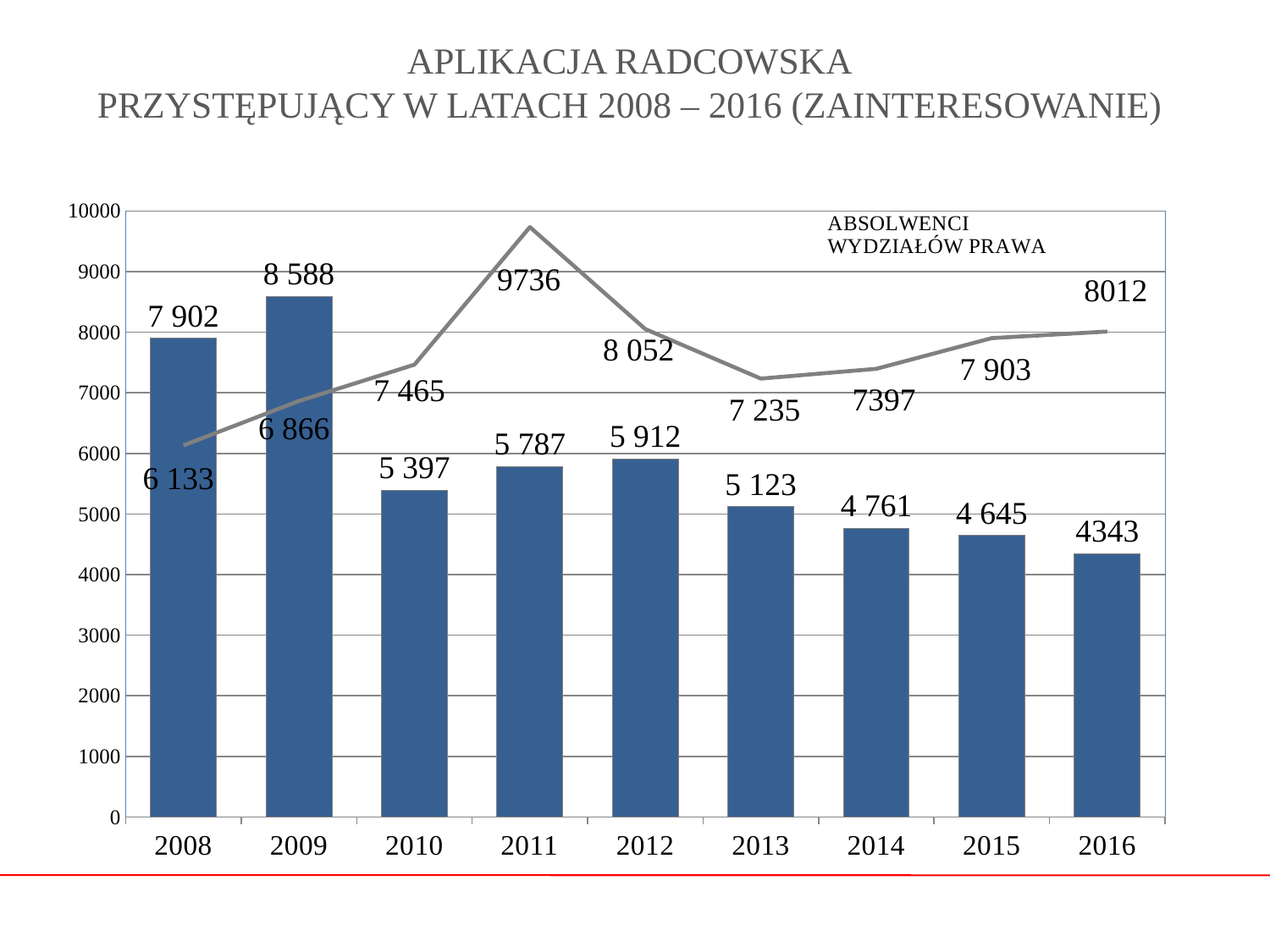
What kind of chart is shown on the slide? A combined bar and line chart What is the value of the bar for 2009? 8 588 What is the value of the ABSOLWENCI WYDZIAŁÓW PRAWA line for 2011? 9736 What is the value of the bar for 2016? 4343 What is the value of the ABSOLWENCI WYDZIAŁÓW PRAWA line for 2008? 6 133 Which is larger, the bar value for 2012 or the bar value for 2013? 2012 In which year does the ABSOLWENCI WYDZIAŁÓW PRAWA line reach its highest value? 2011 Do the bar values generally rise or fall from 2012 to 2016? fall How many years are shown on the x axis? 9 Which year has the highest bar? 2009 What is the difference between the bar values for 2008 and 2009? 686 Which year has the lowest bar? 2016